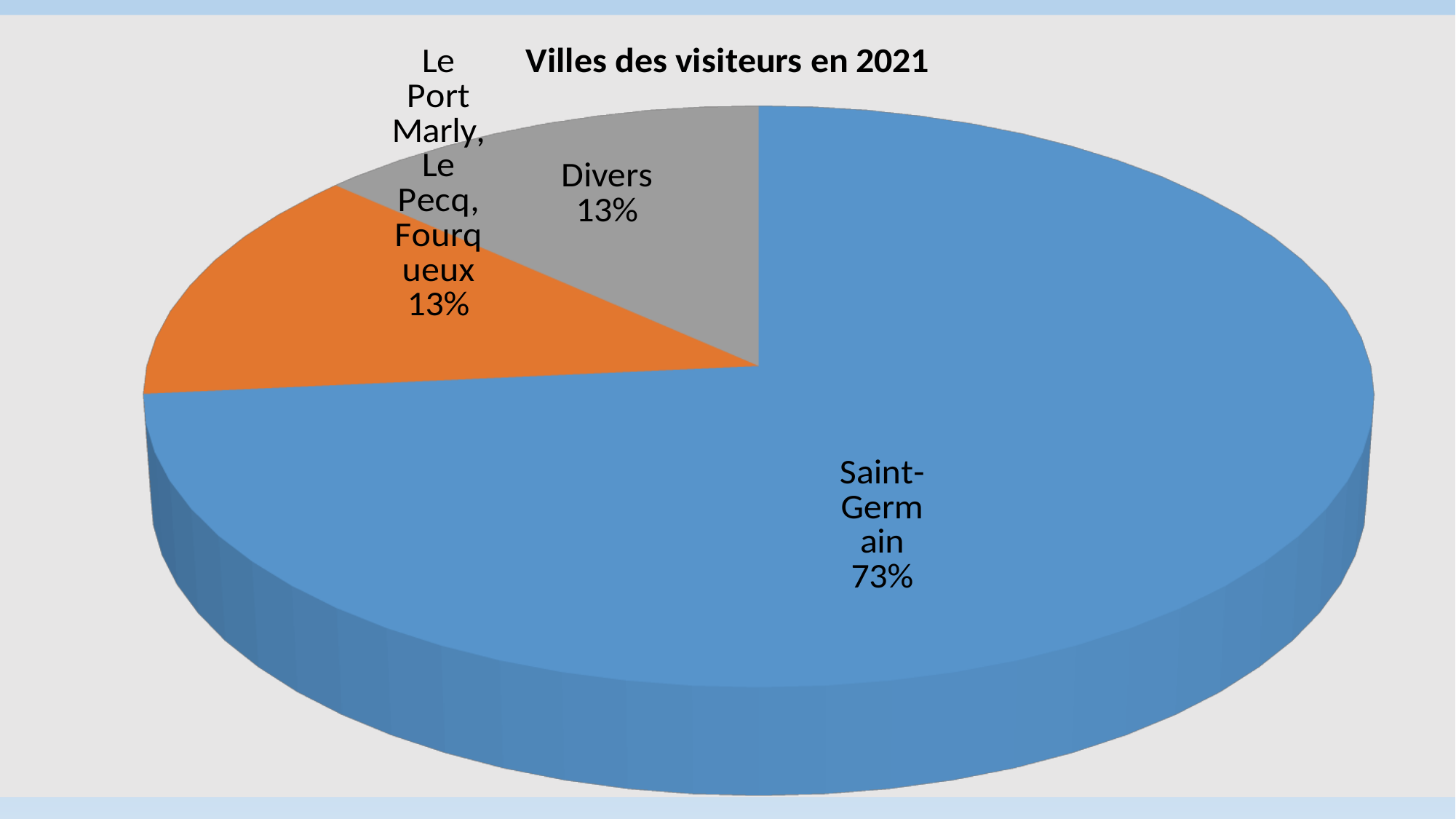
Which category has the largest slice of the pie? Saint-Germain Is the share for Saint-Germain greater or less than 50%? greater Which is larger, the share for Saint-Germain or the share for Divers? Saint-Germain What colour is the Saint-Germain slice? blue What share of the pie does Le Port Marly, Le Pecq, Fourqueux represent? 13% What share of the pie does Saint-Germain represent? 73% What is the difference in percentage points between Saint-Germain and Divers? 60 How many slices does the pie chart have? 3 What kind of chart is shown on the slide? pie chart What is the title of the chart? Villes des visiteurs en 2021 What share of the pie does Divers represent? 13%